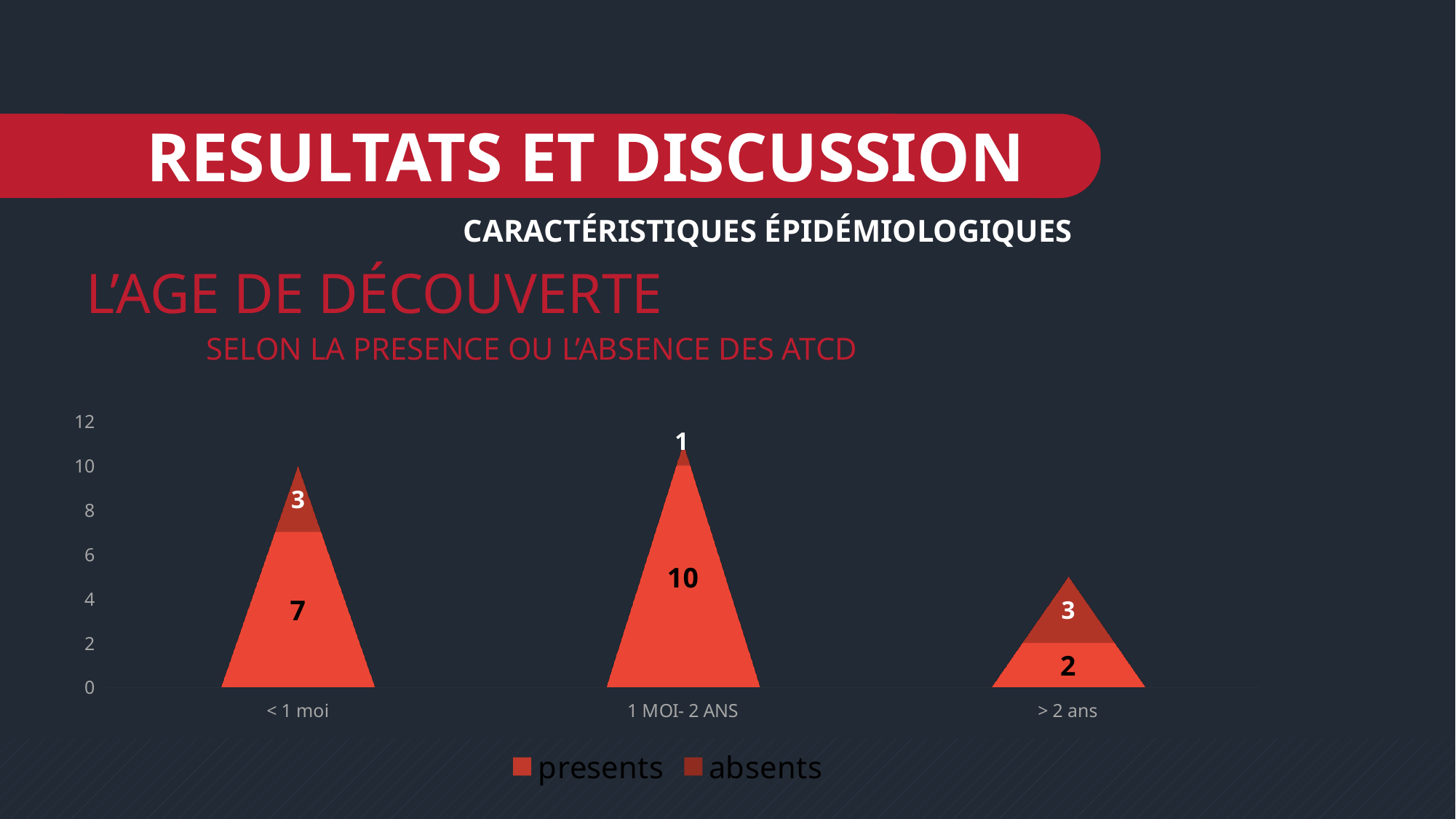
What is the value for 'presents' in the '> 2 ans' category? 2 What is the value for 'absents' in the '1 MOI- 2 ANS' category? 1 How many series does the legend list? 2 How many categories are shown on the x axis? 3 Which category has the lowest 'absents' value? 1 MOI- 2 ANS What is the total of the stacked bar for '1 MOI- 2 ANS'? 11 What is the total of the stacked bar for '< 1 moi'? 10 What is the difference between the 'presents' values for '1 MOI- 2 ANS' and '< 1 moi'? 3 What is the value for 'presents' in the '< 1 moi' category? 7 Which is larger in the '> 2 ans' category: 'presents' or 'absents'? absents Which category has the highest 'presents' value? 1 MOI- 2 ANS What is the value for 'absents' in the '> 2 ans' category? 3